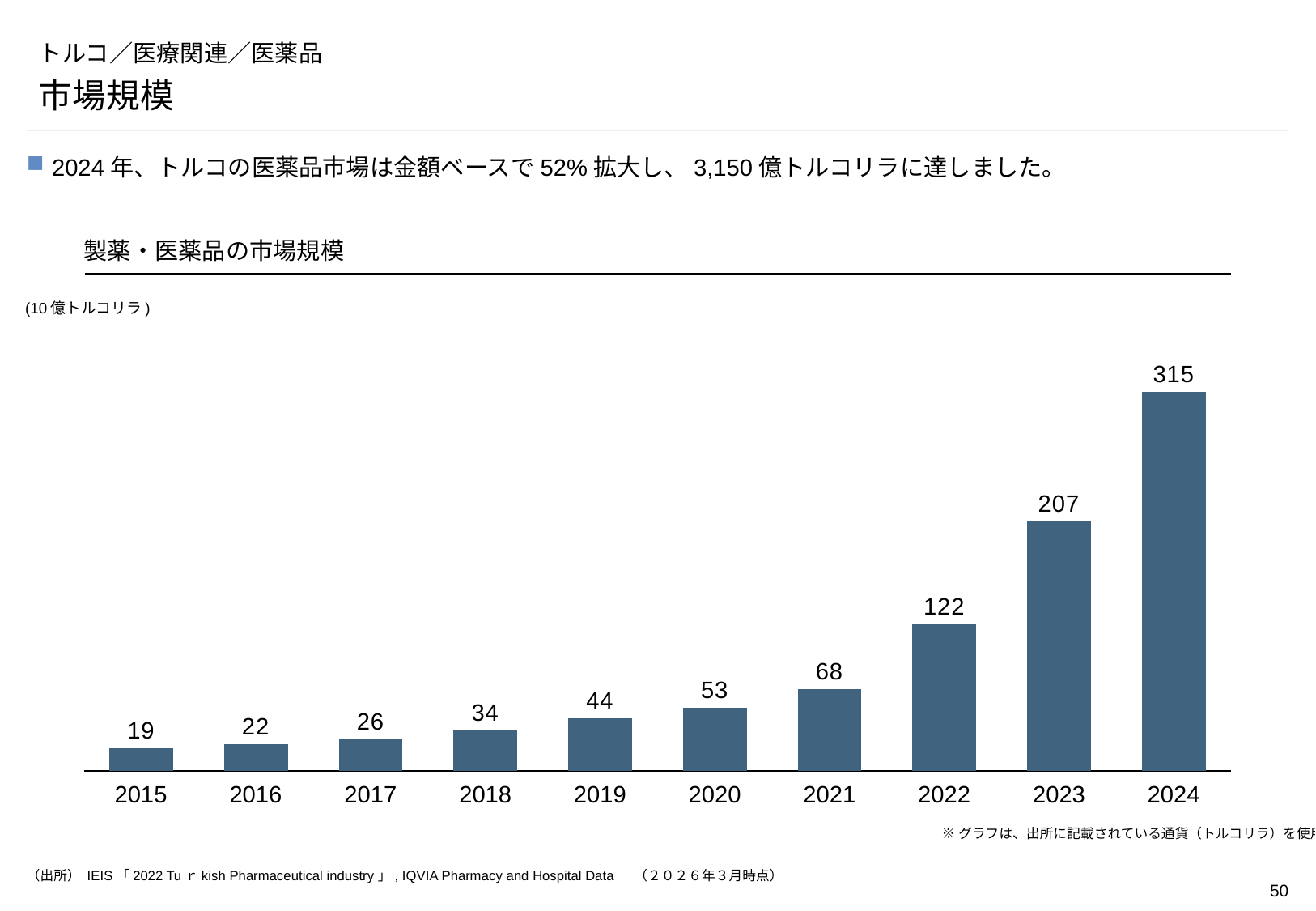
What is the value for 2024? 315 Which year has the lowest value? 2015 How many years are shown on the x axis? 10 What is the value for 2015? 19 What is the difference between the values for 2024 and 2023? 108 What kind of chart is this? bar chart Which is larger, the value for 2020 or the value for 2018? 2020 What is the value for 2019? 44 Which year has the highest value? 2024 What is the difference between the values for 2022 and 2021? 54 Do the values rise or fall from 2015 to 2024? rise What is the title of the chart? 製薬・医薬品の市場規模